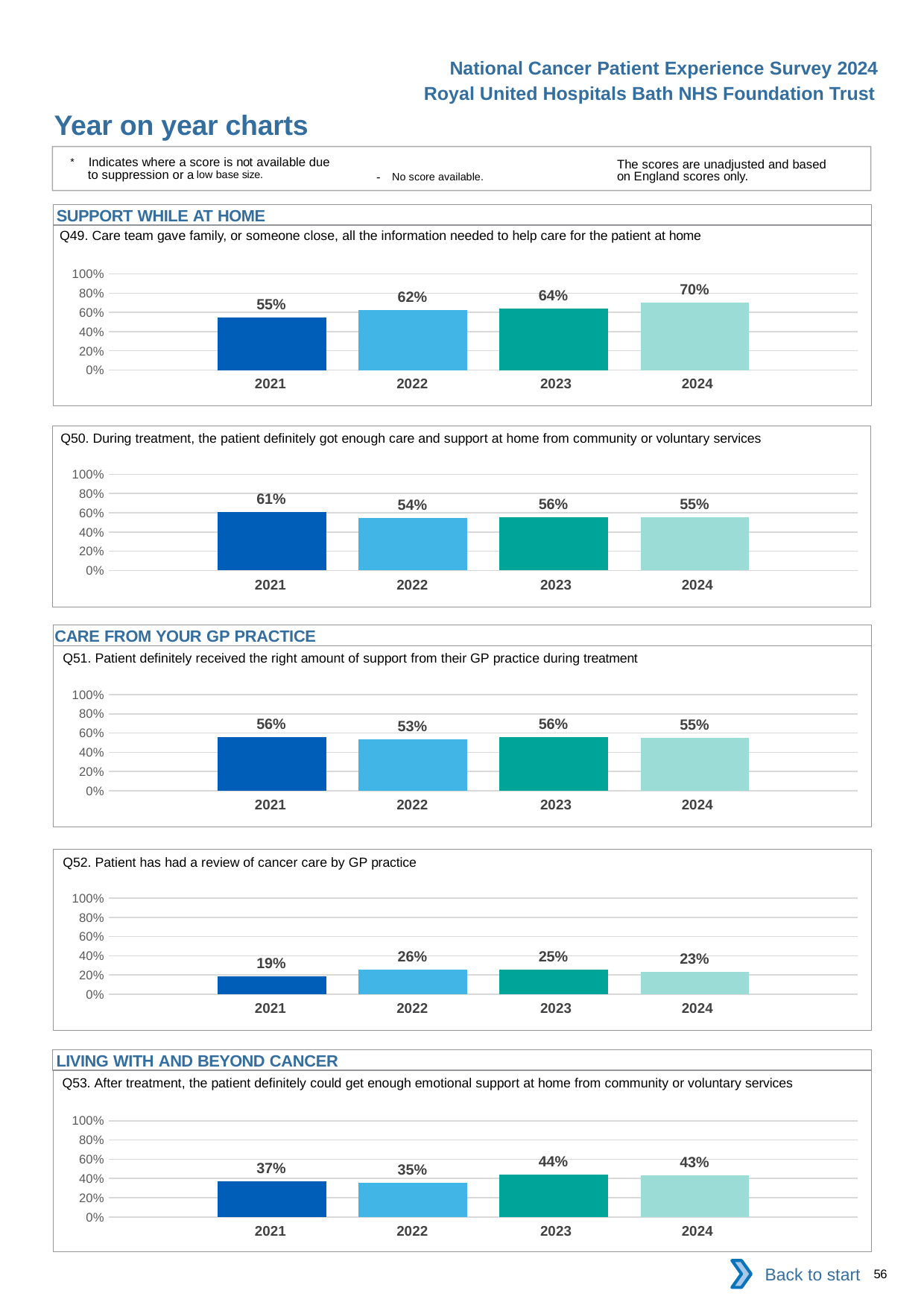
In the Q49 chart, what is the value for 2024? 70% In the Q50 chart, what is the difference between the 2021 and 2022 values? 7 percentage points In the Q53 chart, which is larger, the value for 2023 or the value for 2022? 2023 In the Q51 chart, what is the value for 2024? 55% In the Q52 chart, what is the value for 2021? 19% In the Q49 chart, which year has the lowest value? 2021 What kind of chart is used for Q52? bar chart In the Q50 chart, what is the value for 2021? 61% In the Q49 chart, do the values rise or fall from 2021 to 2024? rise In the Q52 chart, which year has the highest value? 2022 In the Q51 chart, which year has the lowest value? 2022 In the Q53 chart, how many years are plotted? 4